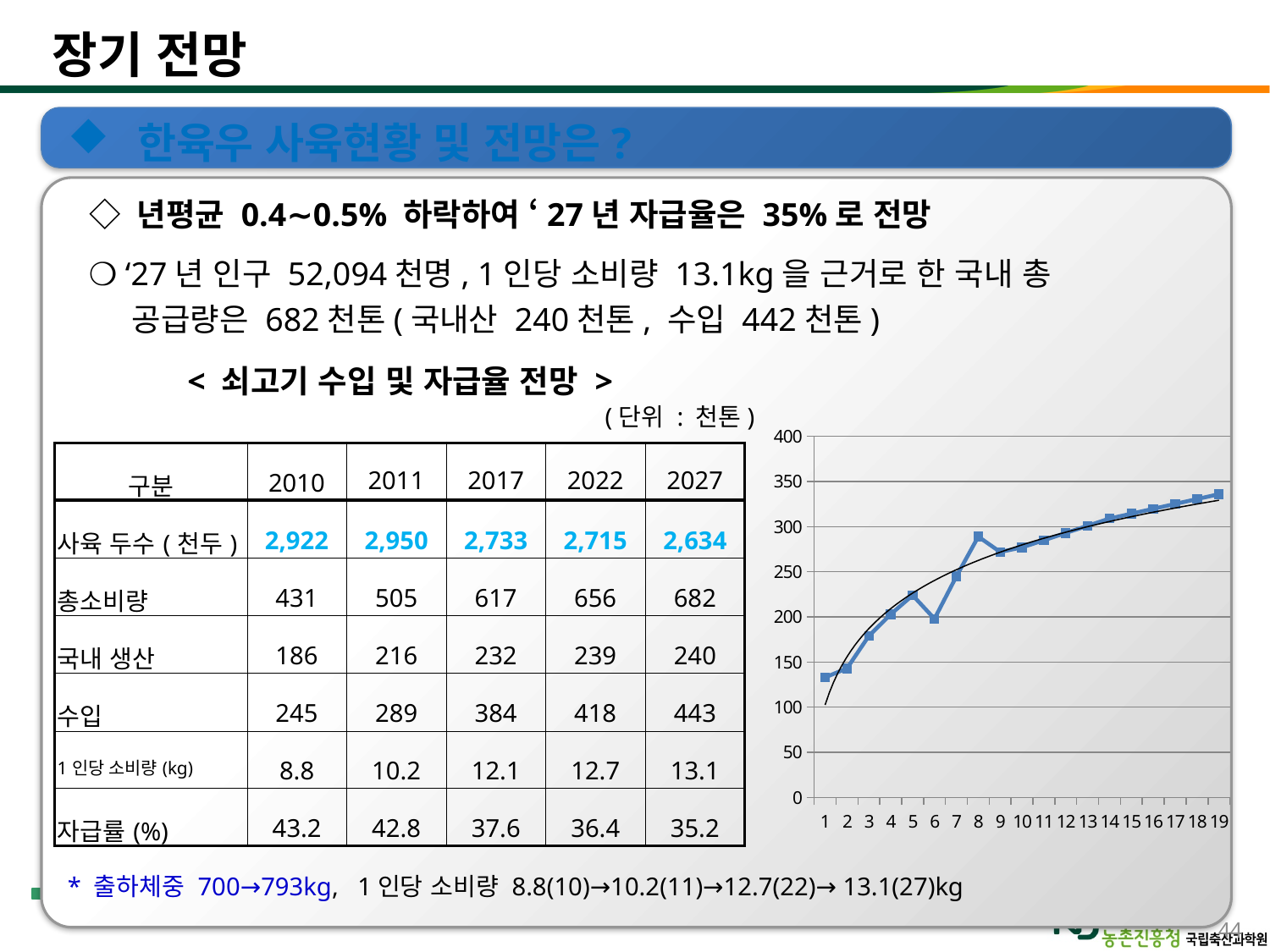
Is the value at x = 6 in the line chart greater or less than 250? less What kind of chart is shown on the right side of the slide? line chart Which x value has the lowest plotted value in the line chart? 1 What is the highest tick value shown on the y axis of the line chart? 400 Is the value at x = 8 in the line chart greater or less than 250? greater Do the values in the line chart generally rise or fall from x = 1 to x = 19? rise Is the value at x = 19 in the line chart greater or less than 300? greater Besides the blue marked line, what other line is drawn on the chart? a black fitted trend line In the line chart, which is larger: the value at x = 8 or the value at x = 6? x = 8 How many data points are plotted along the x axis of the line chart? 19